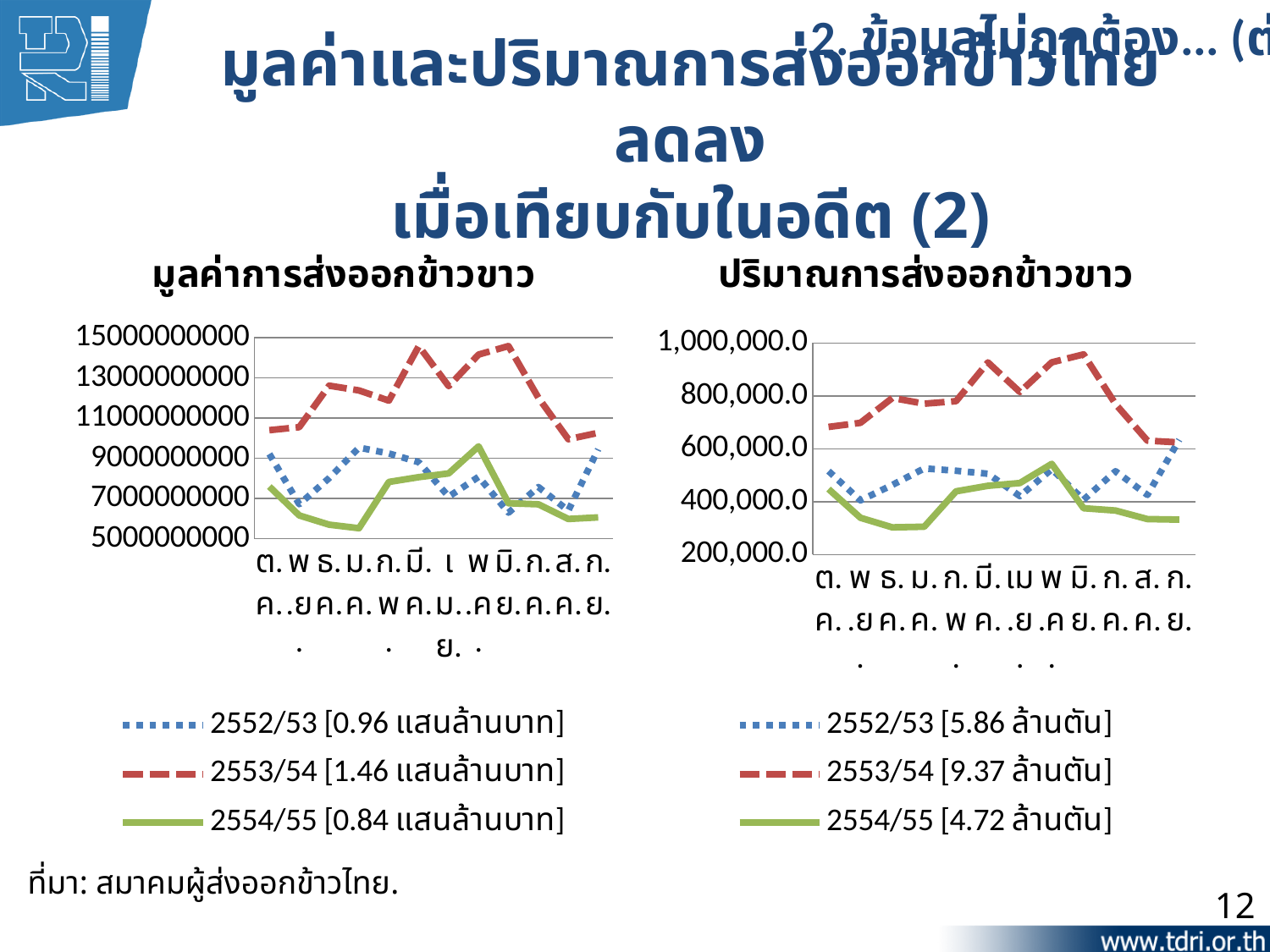
In the left chart (มูลค่าการส่งออกข้าวขาว), is the value for 2554/55 in ธ.ค. greater or less than 7000000000? less In the left chart (มูลค่าการส่งออกข้าวขาว), is the value for 2553/54 in ต.ค. greater or less than 9000000000? greater In the right chart (ปริมาณการส่งออกข้าวขาว), does the 2553/54 series rise or fall from ก.ค. to ก.ย.? fall What type of chart is the left chart titled มูลค่าการส่งออกข้าวขาว? line chart In the right chart (ปริมาณการส่งออกข้าวขาว), is the value for 2553/54 in ต.ค. greater or less than 600,000.0? greater In the left chart (มูลค่าการส่งออกข้าวขาว), which series has the highest values across the year? 2553/54 According to the legend of the left chart (มูลค่าการส่งออกข้าวขาว), what total is shown in brackets for 2553/54? 1.46 แสนล้านบาท In the right chart (ปริมาณการส่งออกข้าวขาว), which is larger in ต.ค.: the value for 2553/54 or for 2552/53? 2553/54 According to the legend of the right chart (ปริมาณการส่งออกข้าวขาว), what total is shown in brackets for 2554/55? 4.72 ล้านตัน How many series does the legend of the right chart (ปริมาณการส่งออกข้าวขาว) list? 3 How many months are plotted along the x axis of the left chart (มูลค่าการส่งออกข้าวขาว)? 12